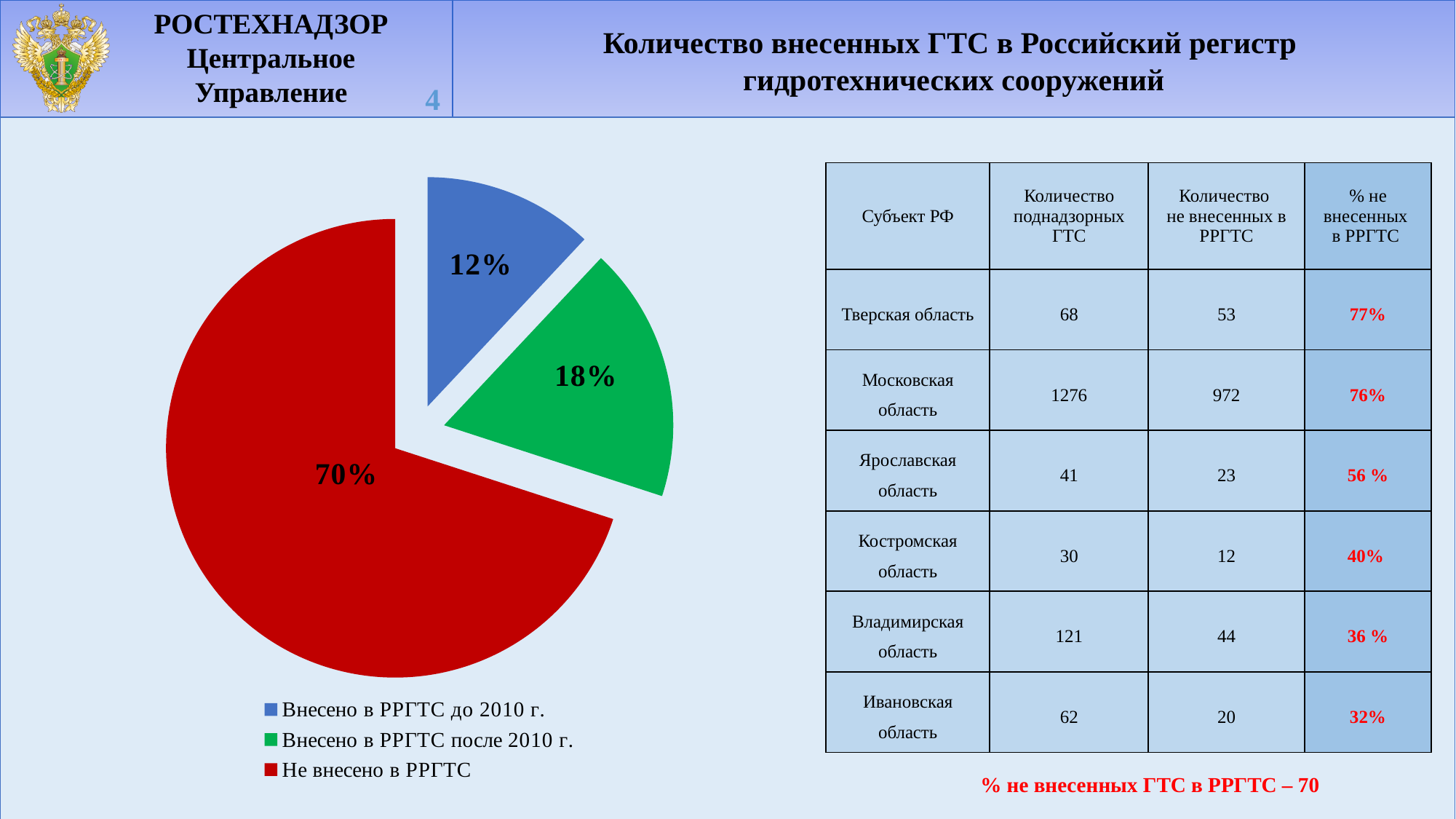
What is the difference in percentage points between the "Не внесено в РРГТС" slice and the "Внесено в РРГТС после 2010 г." slice? 52 What share of the pie is labelled "Не внесено в РРГТС"? 70% What share of the pie is labelled "Внесено в РРГТС после 2010 г."? 18% What share of the pie is labelled "Внесено в РРГТС до 2010 г."? 12% What colour is the slice labelled "Не внесено в РРГТС"? red Which slice of the pie chart is the largest? Не внесено в РРГТС How many entries does the legend of the pie chart list? 3 How many slices does the pie chart have? 3 What kind of chart is shown on the slide? pie chart Which is larger: the share for "Внесено в РРГТС после 2010 г." or the share for "Внесено в РРГТС до 2010 г."? Внесено в РРГТС после 2010 г. What colour is the slice labelled "Внесено в РРГТС после 2010 г."? green Which slice of the pie chart is the smallest? Внесено в РРГТС до 2010 г.